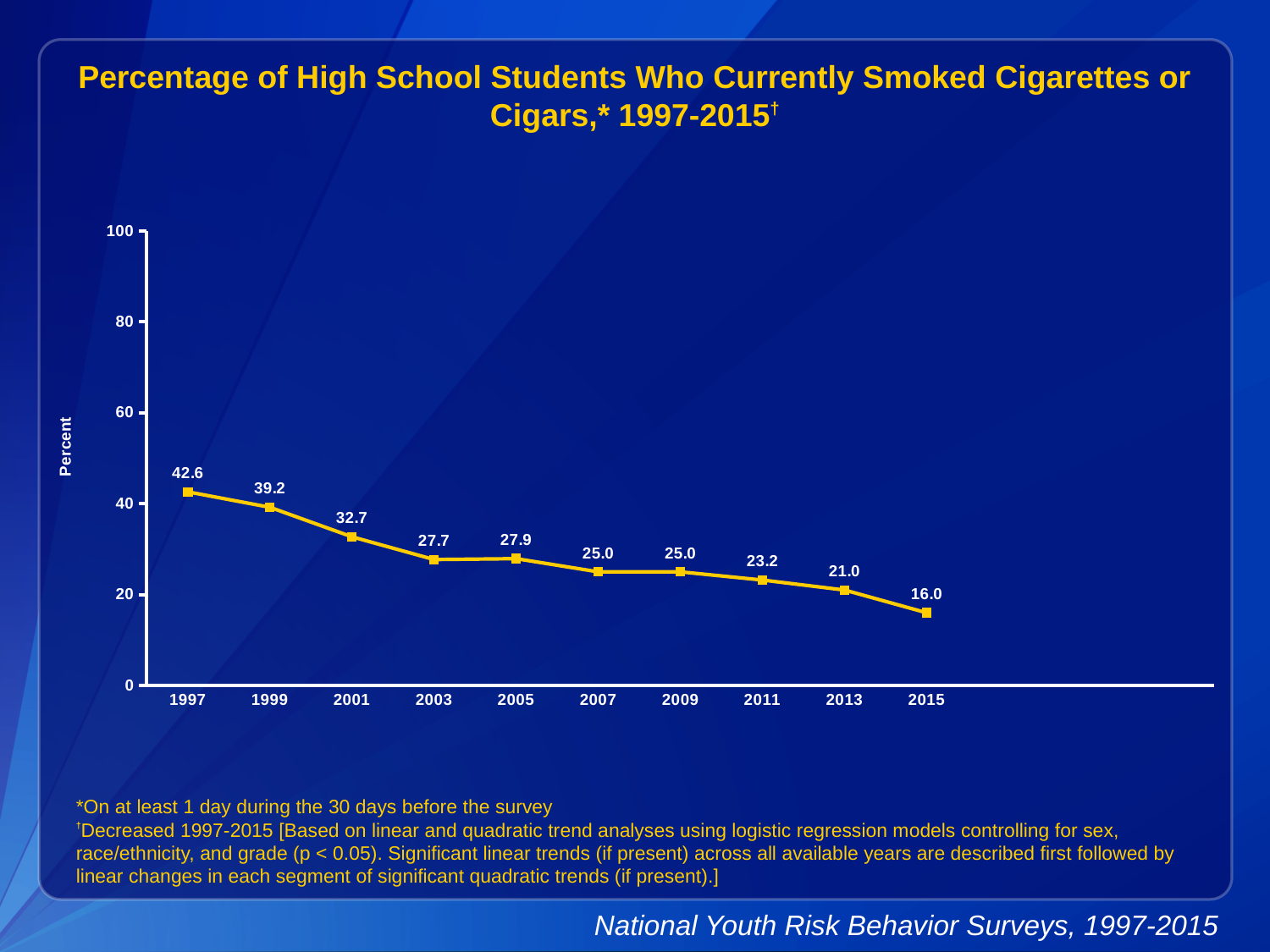
How many years are plotted on the chart? 10 What is the value plotted for 2015? 16.0 Which year has the lowest percentage? 2015 Is the value for 2013 greater or less than 40? less What is the value plotted for 2005? 27.9 Do the values generally rise or fall from 1997 to 2015? fall What is the difference between the 2001 value and the 2003 value? 5.0 What percentage of high school students currently smoked cigarettes or cigars in 1997? 42.6 What kind of chart is shown on the slide? line chart Which year has the highest percentage? 1997 What is the difference between the 1997 value and the 2015 value? 26.6 Which year has a larger value, 1999 or 2011? 1999